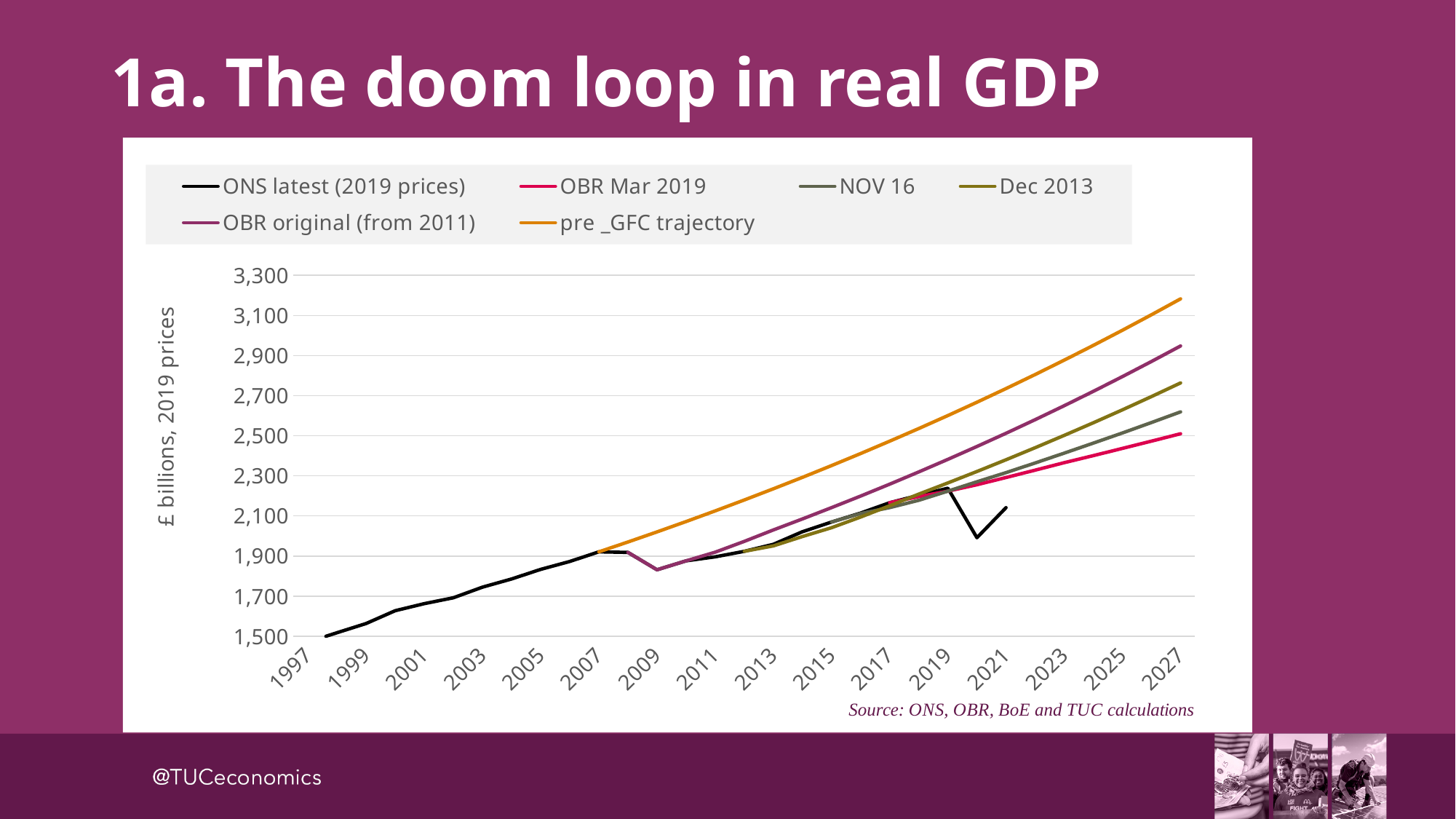
Which series has the lowest value in 2027? OBR Mar 2019 How many series does the legend list? 6 Is the value of the pre _GFC trajectory in 2027 greater or less than 3,100? greater In 2027, which is higher: OBR original (from 2011) or Dec 2013? OBR original (from 2011) Is the value of ONS latest (2019 prices) in 1997 greater or less than 1,700? less Which series reaches the highest value in 2027? pre _GFC trajectory How many year labels are shown on the x axis? 16 What kind of chart is shown on the slide? line chart Is the value of OBR Mar 2019 in 2027 greater or less than 2,700? less Does the ONS latest (2019 prices) series rise or fall between 1997 and 2007? rise What is the label on the y axis? £ billions, 2019 prices